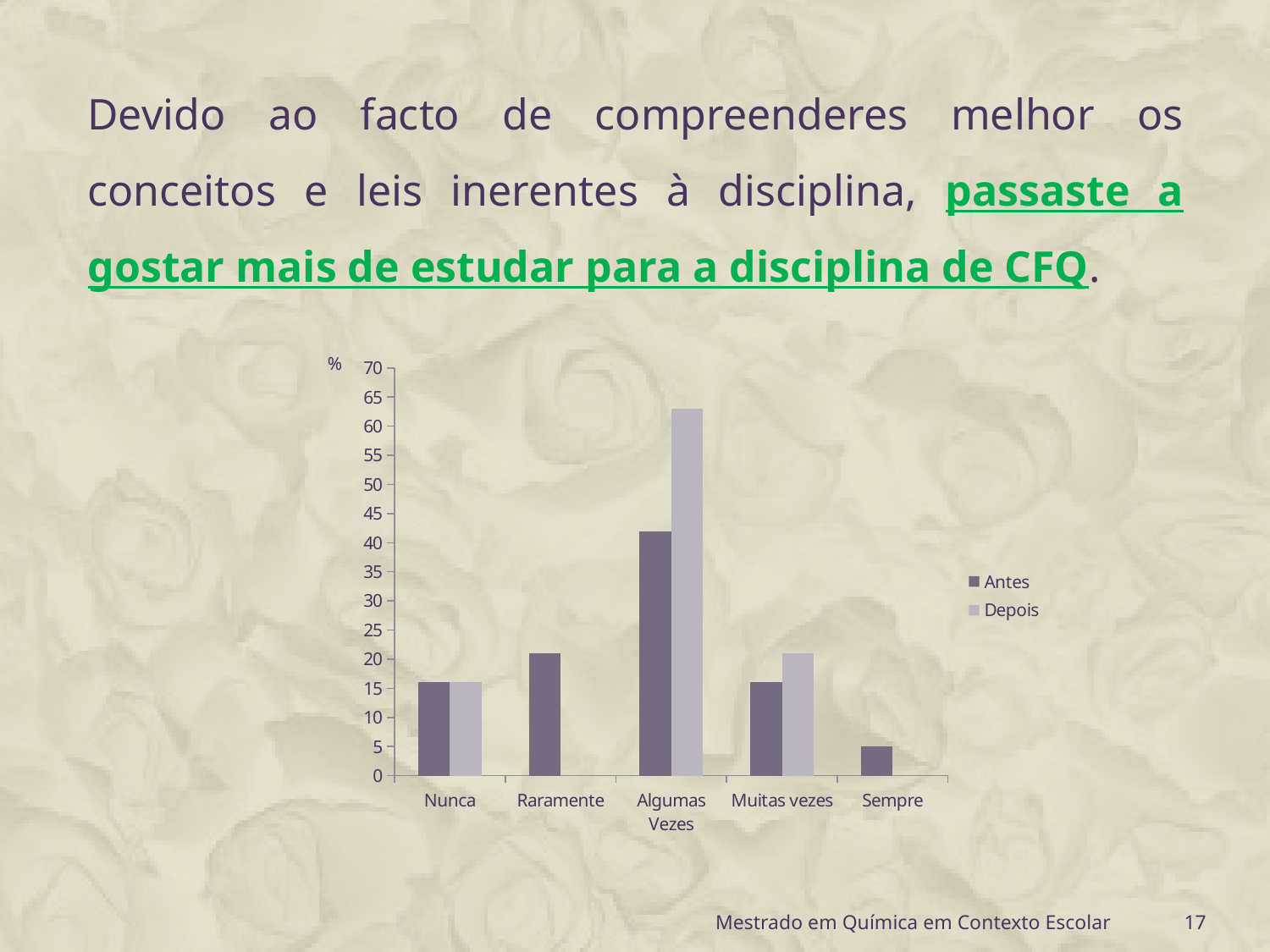
How many categories are shown on the x axis? 5 Is the Antes value for Algumas Vezes greater or less than 35? greater Which category has the lowest value for the Antes series? Sempre How many series does the legend list? 2 What are the two entries listed in the legend? Antes and Depois Is the Depois value for Algumas Vezes greater or less than 60? greater Is the Antes value for Sempre greater or less than 10? less What kind of chart is shown on the slide? bar chart For Muitas vezes, which series has the larger value, Antes or Depois? Depois For Algumas Vezes, which series has the larger value, Antes or Depois? Depois Which category has the highest value for the Depois series? Algumas Vezes Which category has the highest value for the Antes series? Algumas Vezes